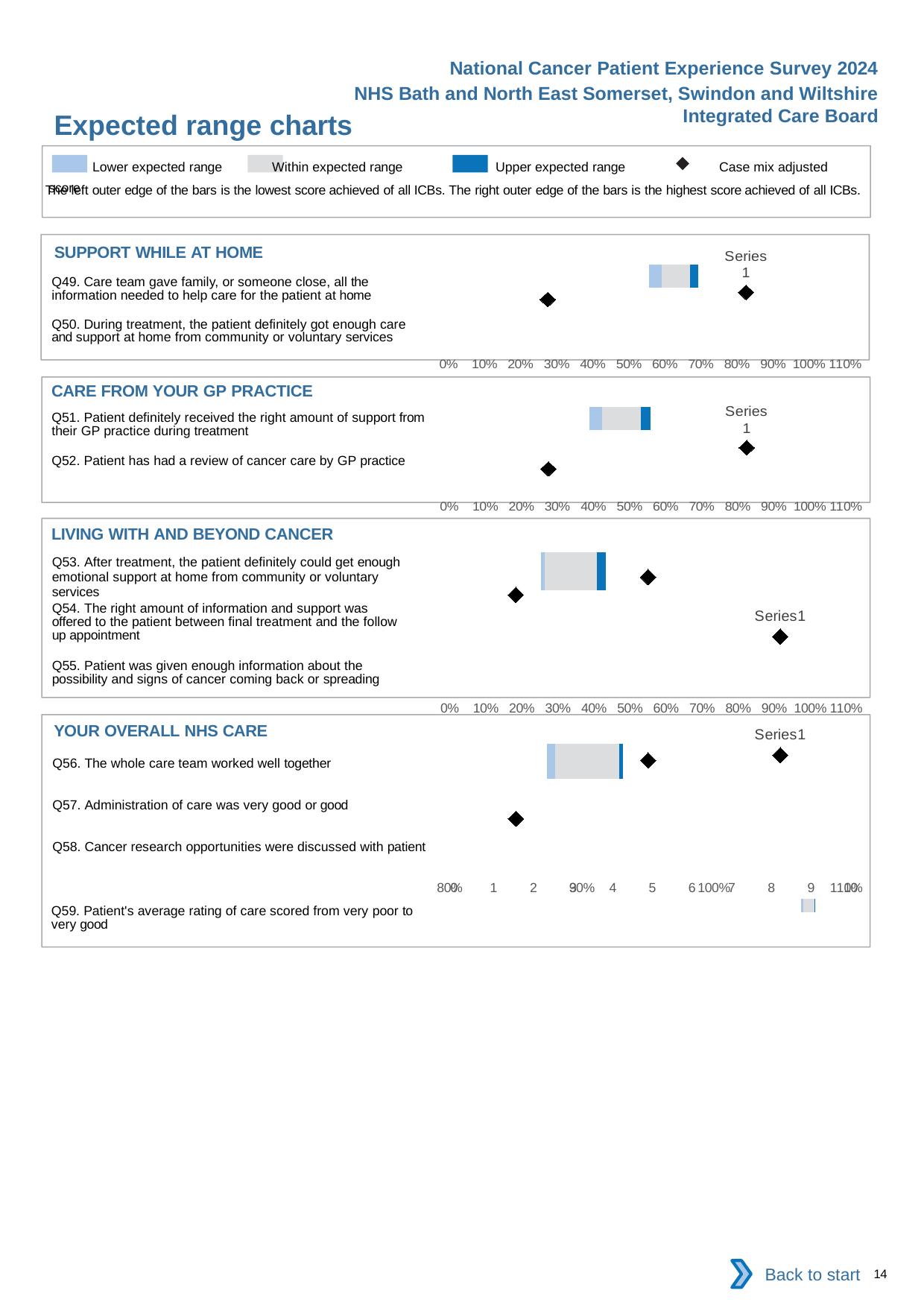
According to the legend, what does the diamond marker represent? Case mix adjusted score In the LIVING WITH AND BEYOND CANCER chart, is the left edge of the expected range bar greater or less than 50%? less How many questions (Q items) are listed in the YOUR OVERALL NHS CARE chart? 4 How many questions (Q items) are listed in the CARE FROM YOUR GP PRACTICE chart? 2 What is the lowest percentage tick shown on the x axis of the CARE FROM YOUR GP PRACTICE chart? 0% In the SUPPORT WHILE AT HOME chart, is the right edge of the expected range bar greater or less than 50%? greater In the CARE FROM YOUR GP PRACTICE chart, is the left edge of the expected range bar greater or less than 30%? greater What is the highest percentage tick shown on the x axis of the SUPPORT WHILE AT HOME chart? 110% How many questions (Q items) are listed in the LIVING WITH AND BEYOND CANCER chart? 3 How many entries does the legend at the top of the slide list? 4